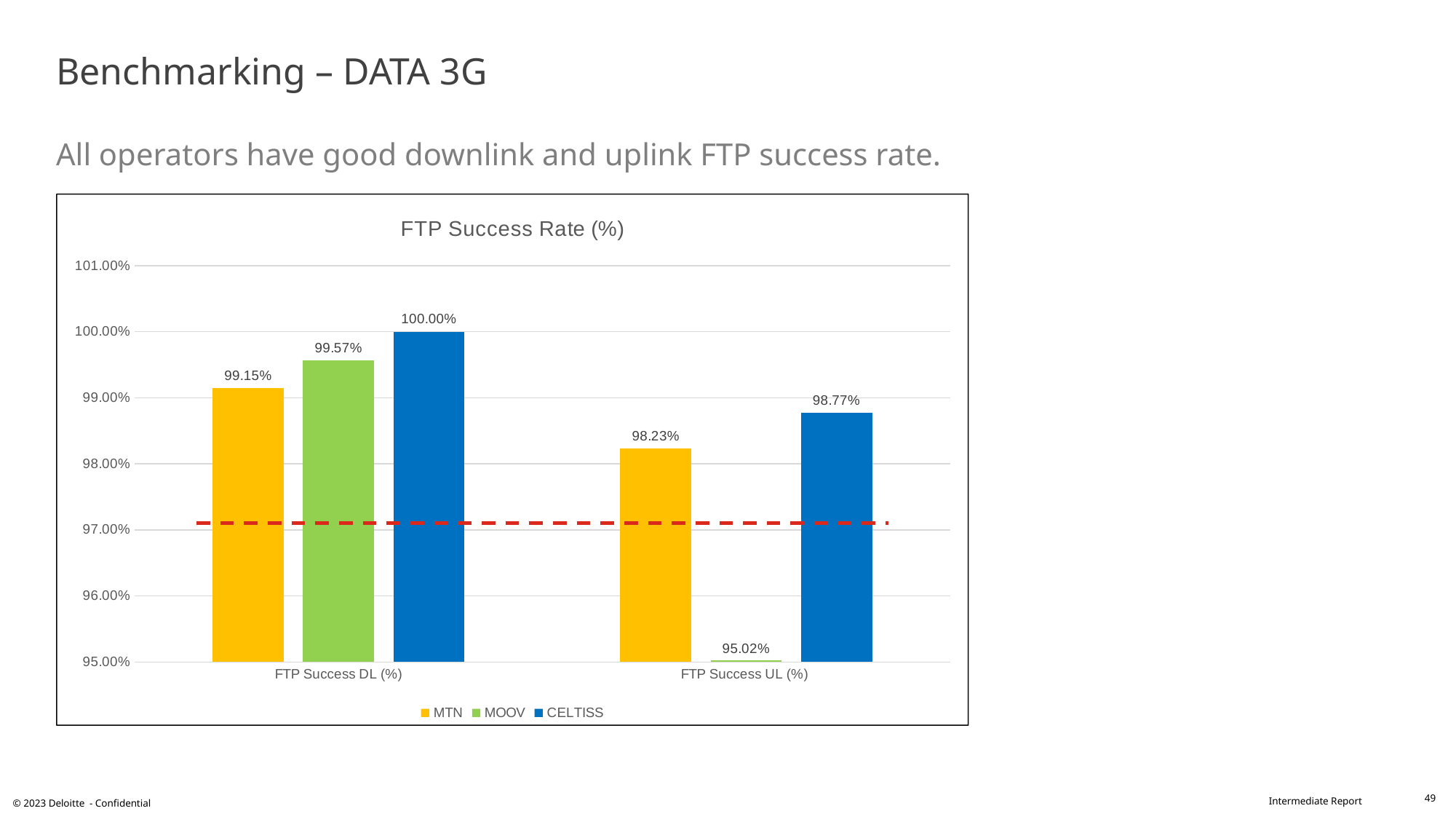
How many series does the legend list? 3 What kind of chart is shown on the slide? Bar chart Which operator has the lowest FTP Success UL (%)? MOOV What is the title of the chart? FTP Success Rate (%) What is the FTP Success UL (%) value for MOOV? 95.02% Which is larger: MOOV's FTP Success DL (%) or MTN's FTP Success DL (%)? MOOV What is the FTP Success UL (%) value for CELTISS? 98.77% How many categories are shown on the x axis? 2 What is the FTP Success DL (%) value for CELTISS? 100.00% What is the FTP Success DL (%) value for MTN? 99.15% Which operator has the highest FTP Success DL (%)? CELTISS What is the difference between CELTISS and MTN for FTP Success UL (%)? 0.54%